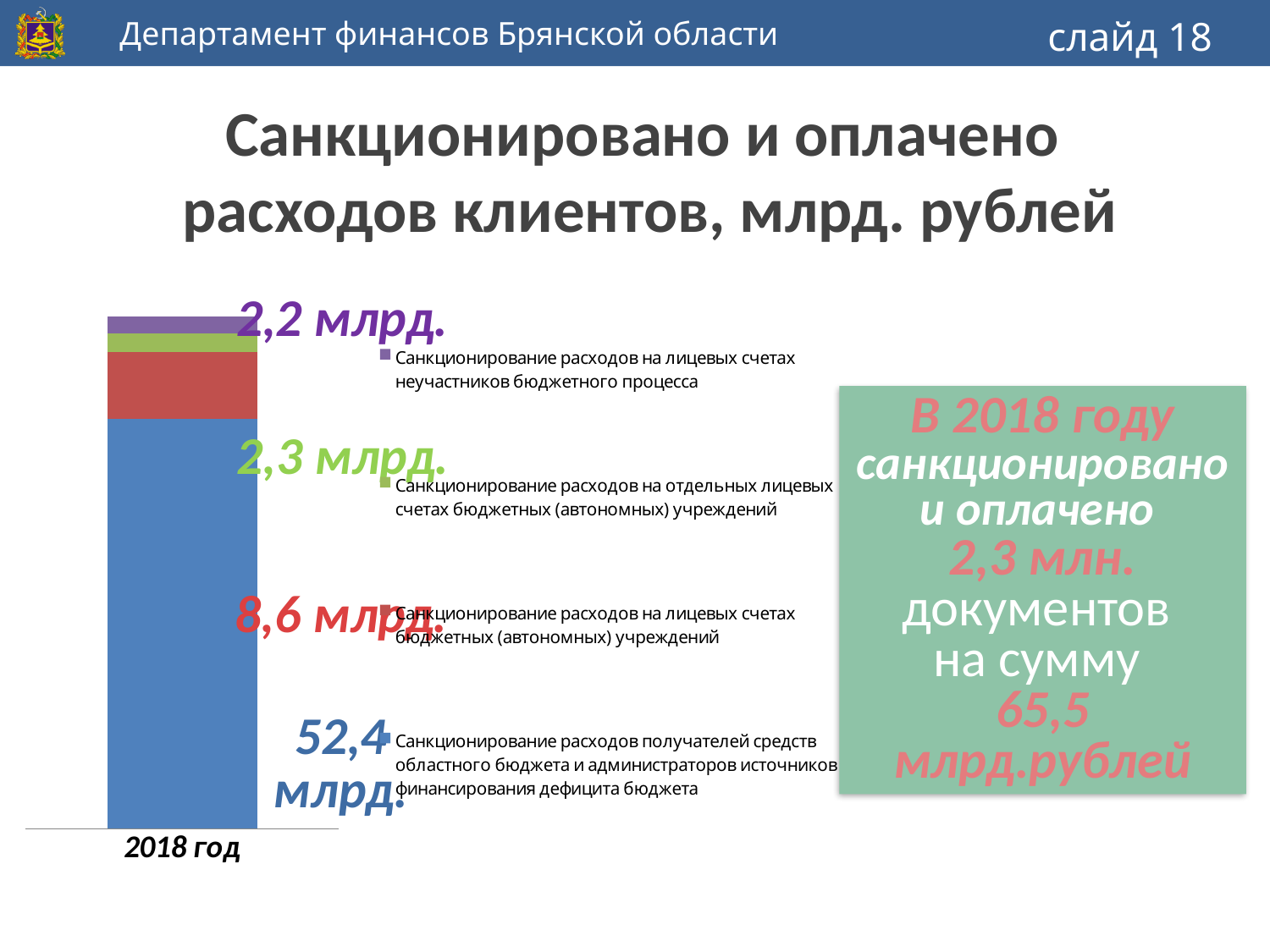
What is the value for 'Санкционирование расходов на отдельных лицевых счетах бюджетных (автономных) учреждений' in 2018? 2,3 млрд. How many categories are plotted on the x axis? 1 Which series has the largest value in the 2018 bar? Санкционирование расходов получателей средств областного бюджета и администраторов источников финансирования дефицита бюджета What kind of chart is shown on the slide? Stacked bar chart Which series has the smallest value in the 2018 bar? Санкционирование расходов на лицевых счетах неучастников бюджетного процесса What is the value for 'Санкционирование расходов получателей средств областного бюджета и администраторов источников финансирования дефицита бюджета' in 2018? 52,4 млрд. How many series does the legend list? 4 What is the value for 'Санкционирование расходов на лицевых счетах бюджетных (автономных) учреждений' in 2018? 8,6 млрд. What is the total of the stacked bar for 2018 год? 65,5 млрд. What is the difference between the value for 'Санкционирование расходов получателей средств областного бюджета...' (52,4 млрд.) and 'Санкционирование расходов на лицевых счетах бюджетных (автономных) учреждений' (8,6 млрд.)? 43,8 млрд. What is the value for 'Санкционирование расходов на лицевых счетах неучастников бюджетного процесса' in 2018? 2,2 млрд. Which category label is shown on the x axis of the chart? 2018 год